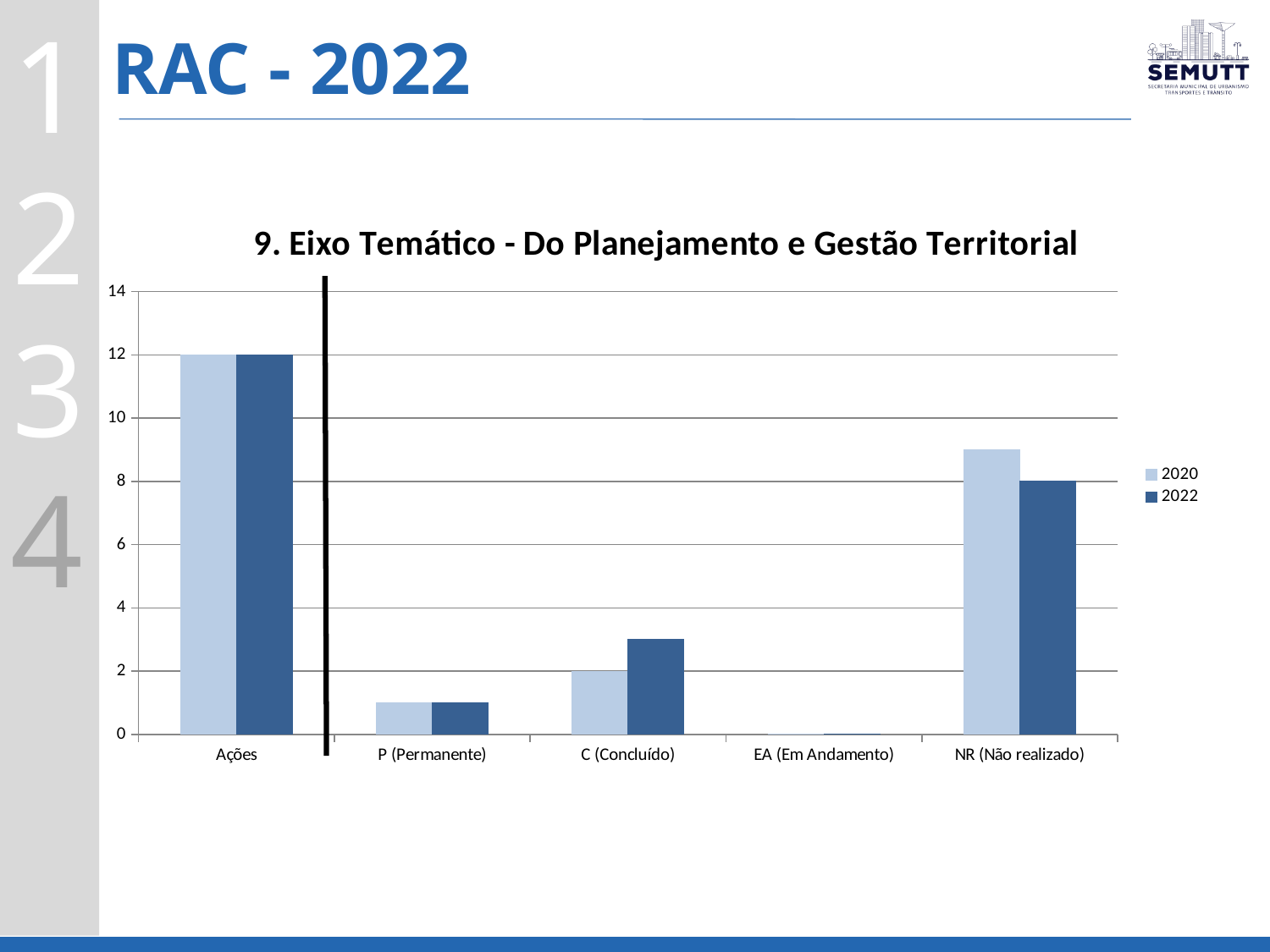
What is the value for NR (Não realizado) in the 2022 series? 8 Which category has the highest value in the 2020 series? Ações What is the value for C (Concluído) in the 2020 series? 2 What is the value for Ações in the 2022 series? 12 How many series does the legend list? 2 What type of chart is shown on the slide? bar chart What is the title of the chart? 9. Eixo Temático - Do Planejamento e Gestão Territorial Is the value for NR (Não realizado) in the 2020 series greater or less than 8? greater For NR (Não realizado), which series has the larger value, 2020 or 2022? 2020 What is the difference between the 2022 values for Ações and NR (Não realizado)? 4 How many categories are shown on the x axis? 5 Which category has the lowest value in the 2022 series? EA (Em Andamento)